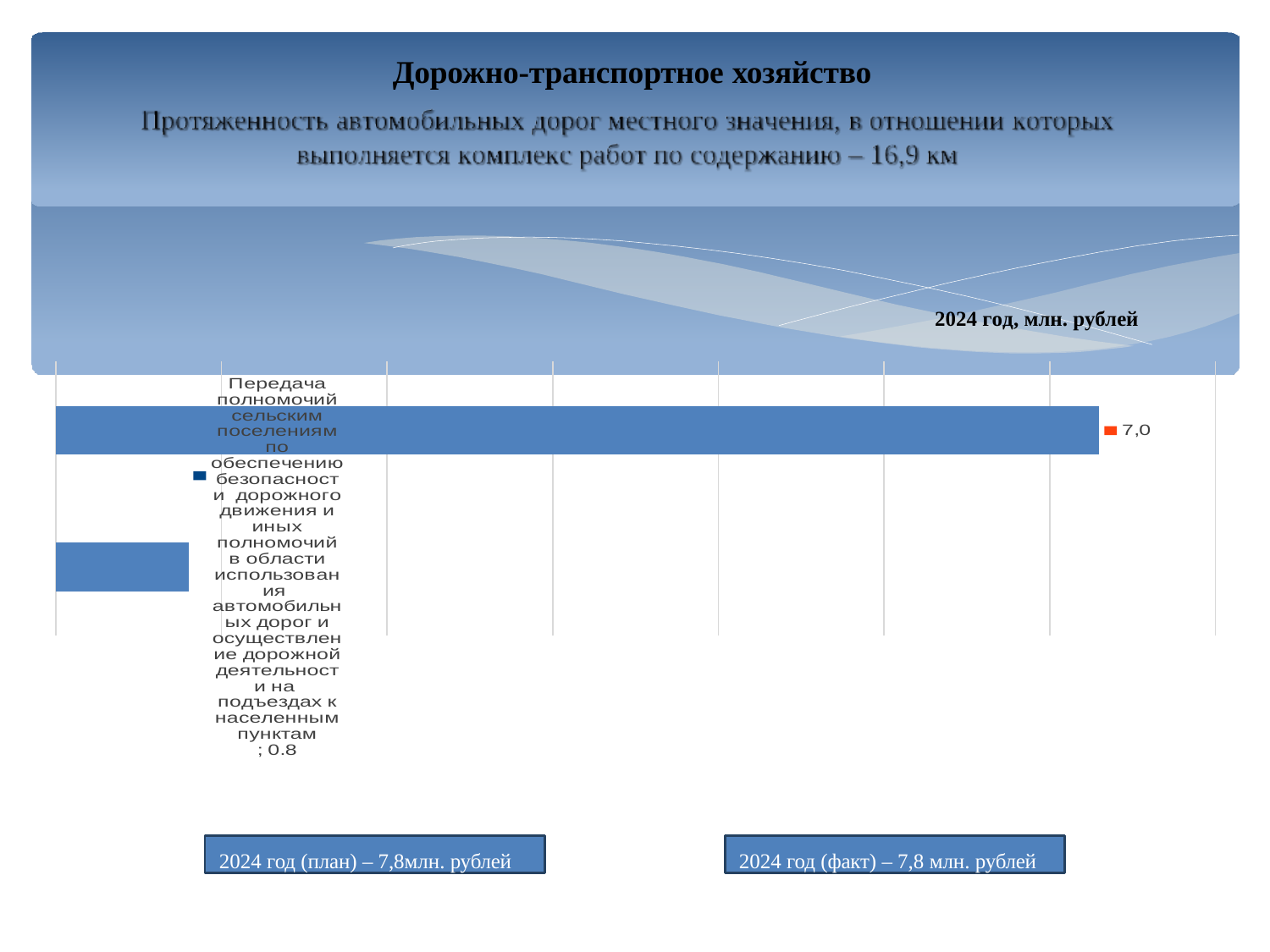
According to the text box below the chart, what was the 2024 planned amount in million rubles? 7,8 What is the total of the two labeled values in the chart (7,0 and 0.8)? 7,8 What is the difference between the two labeled values in the chart, 7,0 and 0.8? 6,2 What is the value for the category 'Передача полномочий сельским поселениям по обеспечению безопасности дорожного движения и иных полномочий в области использования автомобильных дорог и осуществление дорожной деятельности на подъездах к населенным пунктам'? 0.8 What value is labeled on the longest bar in the chart? 7,0 What kind of chart is shown on the slide? bar chart What is the title of the chart? 2024 год, млн. рублей What is the smallest value labeled in the chart? 0.8 How many bars are plotted in the chart? 2 Is the bar labeled 7,0 larger or smaller than the bar for 'Передача полномочий сельским поселениям...'? larger